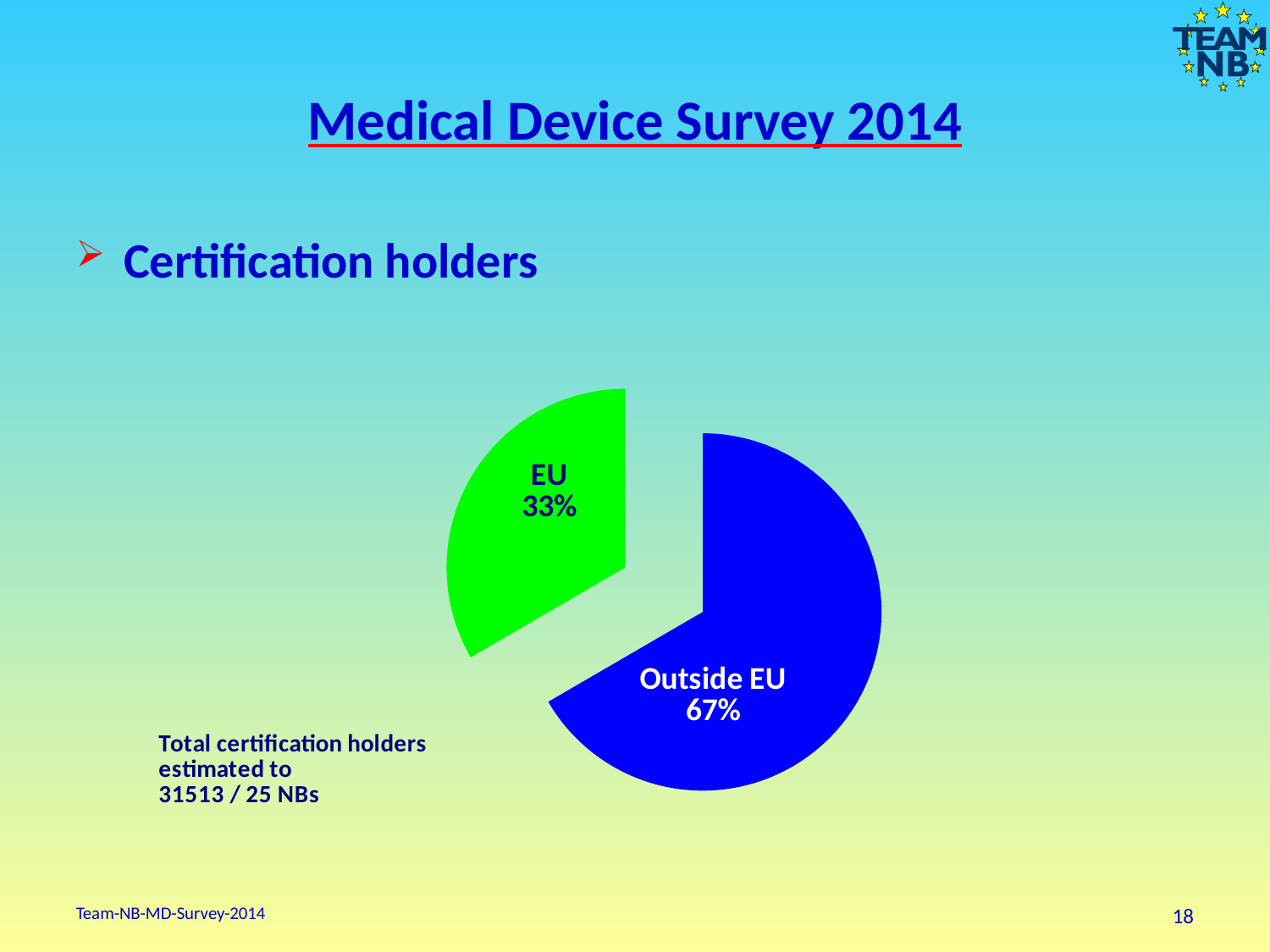
What kind of chart is shown on the slide? Pie chart Which slice of the pie chart is the smallest? EU How many slices does the pie chart have? 2 What is the total number of certification holders estimated to be, according to the text next to the chart? 31513 / 25 NBs What colour is the EU slice of the pie chart? Green What is the difference in percentage points between the Outside EU and EU slices? 34 Which is larger, the EU slice or the Outside EU slice? Outside EU Which slice of the pie chart is the largest? Outside EU What share of certification holders is from the EU? 33% What colour is the Outside EU slice of the pie chart? Blue What share of certification holders is from outside the EU? 67%